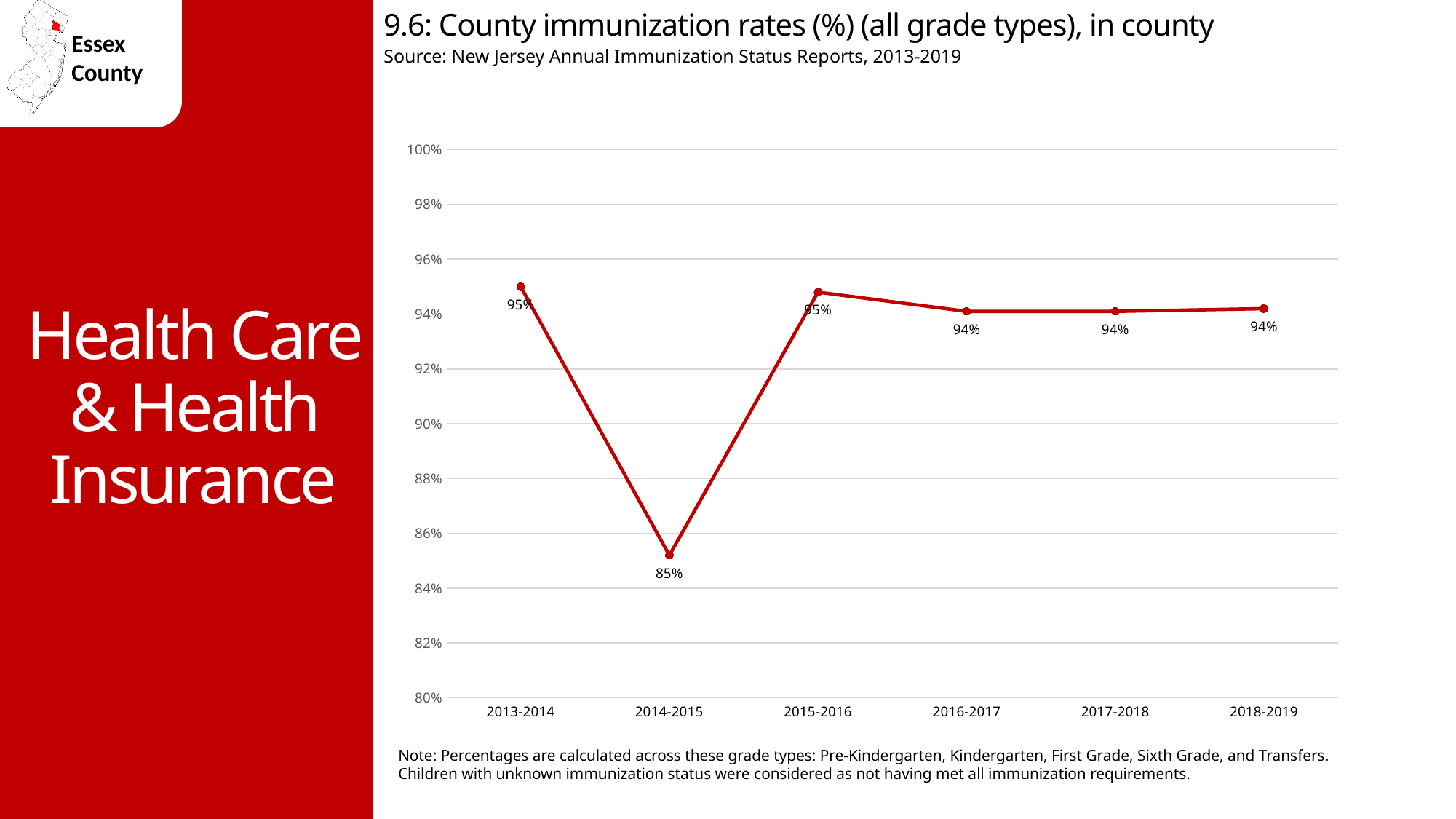
Which is larger, the immunization rate for 2014-2015 or for 2016-2017? 2016-2017 Is the value for 2014-2015 greater or less than 86%? less What kind of chart is shown on the slide? line chart What is the county immunization rate for 2018-2019? 94% How many school years are plotted on the chart? 6 What is the difference in percentage points between the 2013-2014 rate and the 2014-2015 rate? 10 percentage points Is the value for 2017-2018 greater or less than 90%? greater What is the county immunization rate for 2016-2017? 94% What is the county immunization rate for 2013-2014? 95% What is the county immunization rate for 2014-2015? 85% Does the immunization rate rise or fall from 2013-2014 to 2014-2015? fall Which school year has the lowest immunization rate? 2014-2015